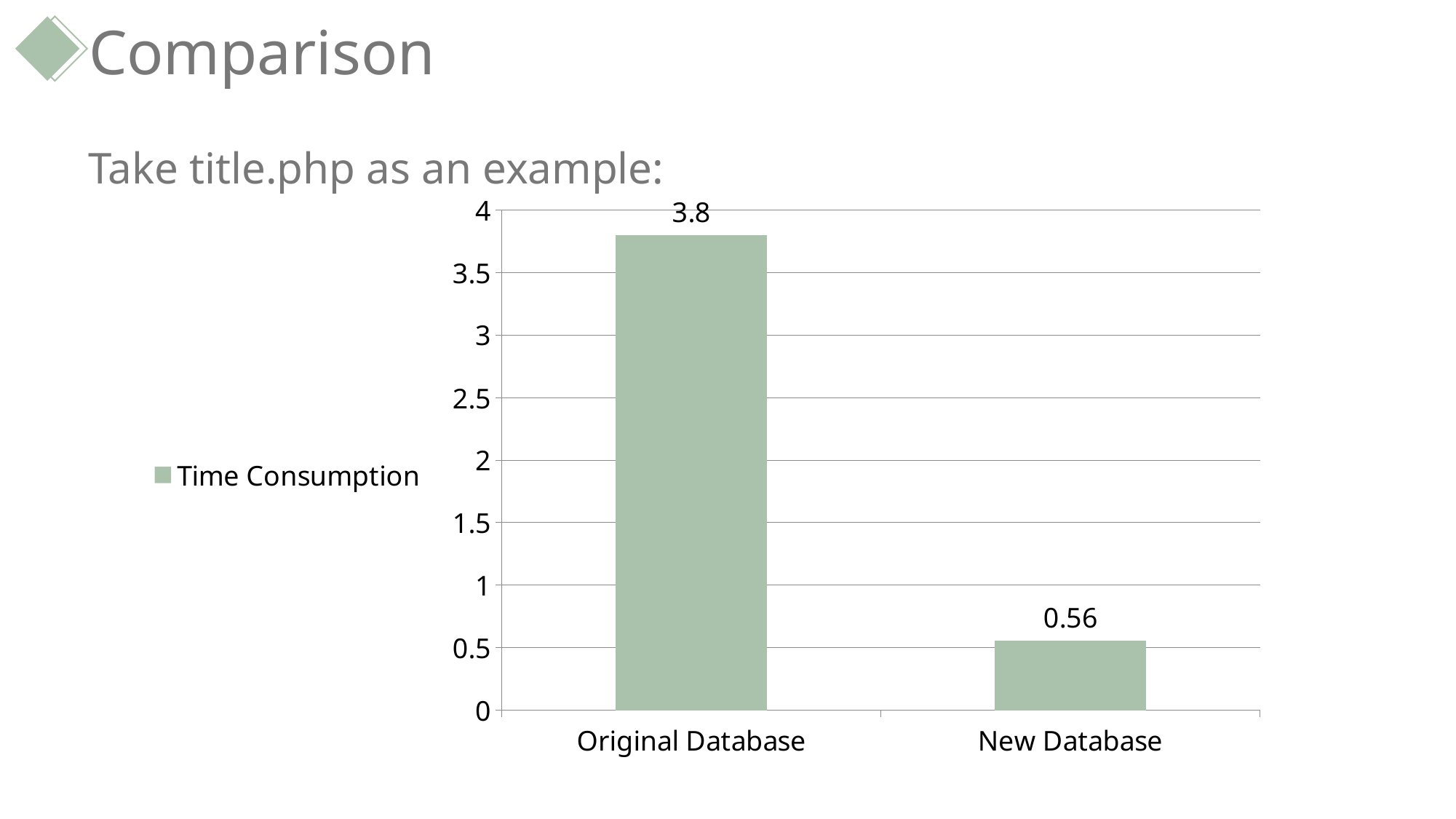
How many categories are shown on the x axis of the chart? 2 Which category has the highest Time Consumption? Original Database Which category has the lowest Time Consumption? New Database What is the Time Consumption value for Original Database? 3.8 What is the Time Consumption value for New Database? 0.56 Which has a larger Time Consumption, Original Database or New Database? Original Database What kind of chart is shown on the slide? bar chart How many series does the chart legend list? 1 Is the Time Consumption for New Database greater or less than 1? less What is the name of the series shown in the chart legend? Time Consumption Is the Time Consumption for Original Database greater or less than 3.5? greater What is the difference in Time Consumption between Original Database and New Database? 3.24